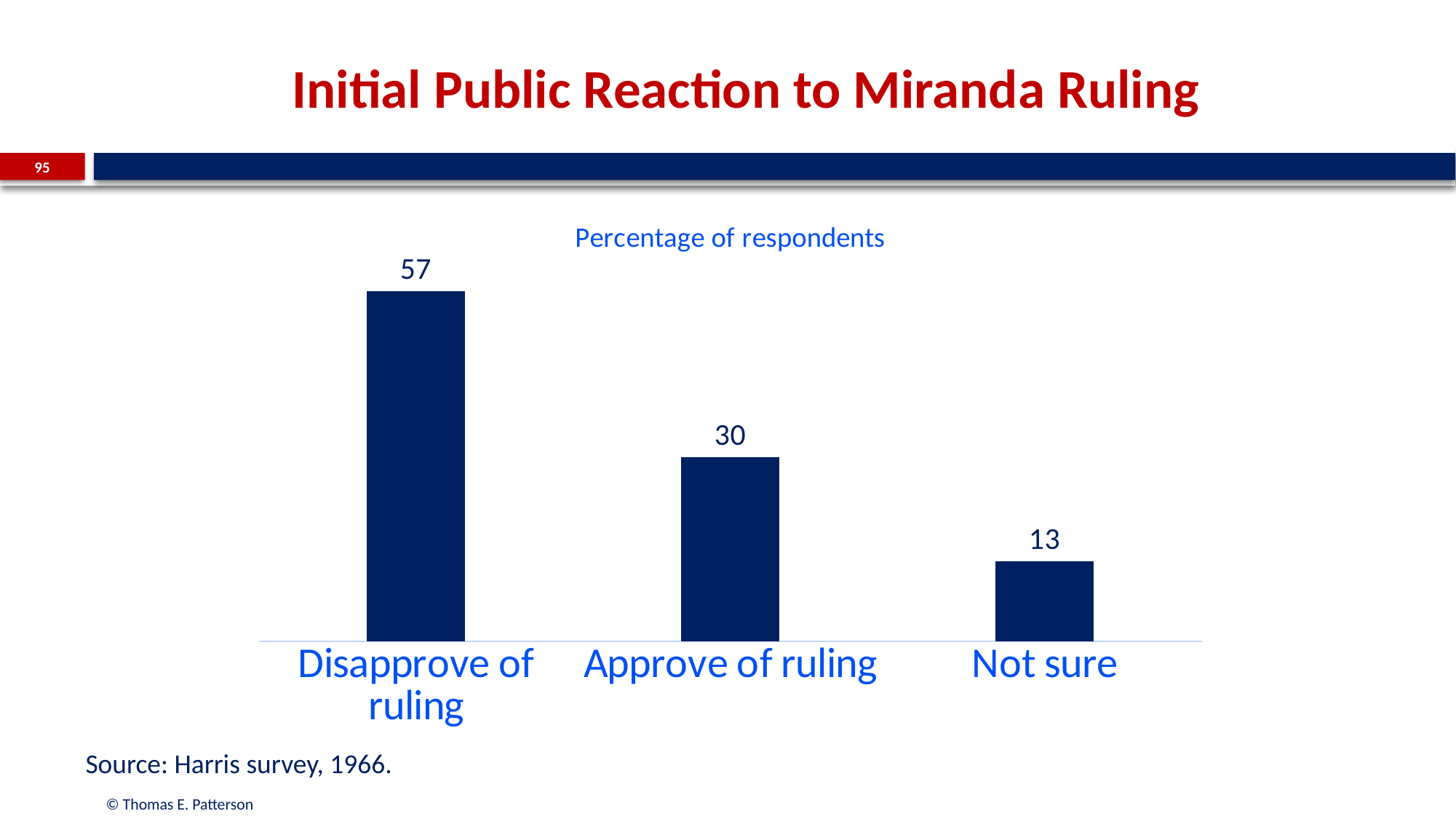
Which is larger, the value for Approve of ruling or the value for Not sure? Approve of ruling How many categories are shown in the chart? 3 Do the values rise or fall from left to right across the categories? Fall What is the value for Disapprove of ruling? 57 Which category has the lowest value? Not sure What kind of chart is shown on the slide? Bar chart What is the title of the chart? Percentage of respondents What is the value for Approve of ruling? 30 Which category has the highest value? Disapprove of ruling What is the value for Not sure? 13 What is the difference between the values for Disapprove of ruling and Approve of ruling? 27 What is the difference between the values for Approve of ruling and Not sure? 17